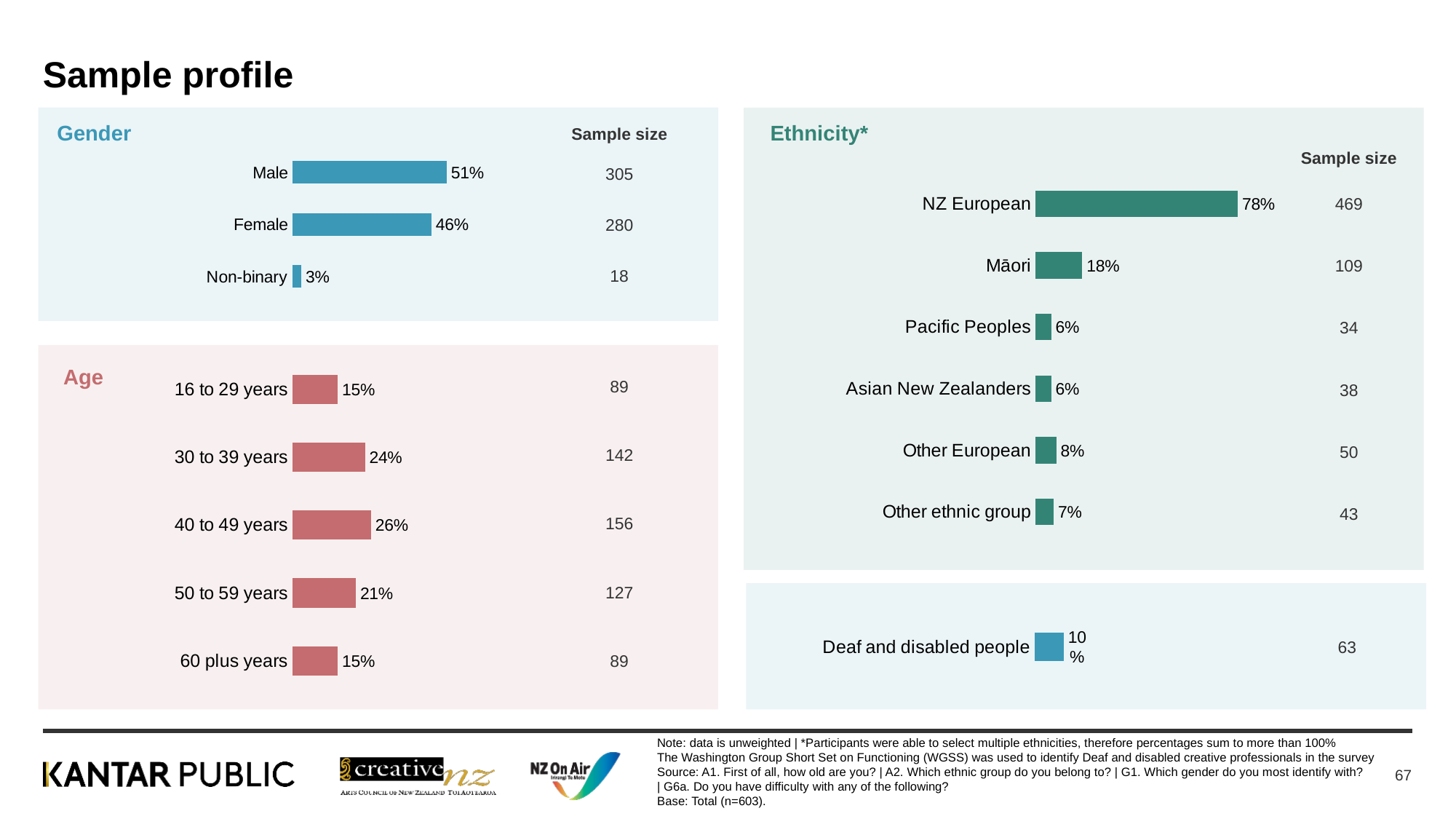
In the Ethnicity chart, how many categories are shown? 6 In the Gender chart, what percentage is shown for Male? 51% In the Ethnicity chart, which category has the highest percentage? NZ European In the Age chart, what is the sample size for 50 to 59 years? 127 What kind of chart is used in the Gender panel? bar chart In the Ethnicity chart, is the percentage for Other European larger or smaller than that for Other ethnic group? larger In the Ethnicity chart, what percentage is shown for Māori? 18% In the Age chart, what is the difference in percentage points between 30 to 39 years and 16 to 29 years? 9 In the Age chart, which age group has the highest percentage? 40 to 49 years In the Gender chart, which category has the lowest percentage? Non-binary In the Age chart, how many age groups are shown? 5 In the Gender chart, what is the sample size for Female? 280